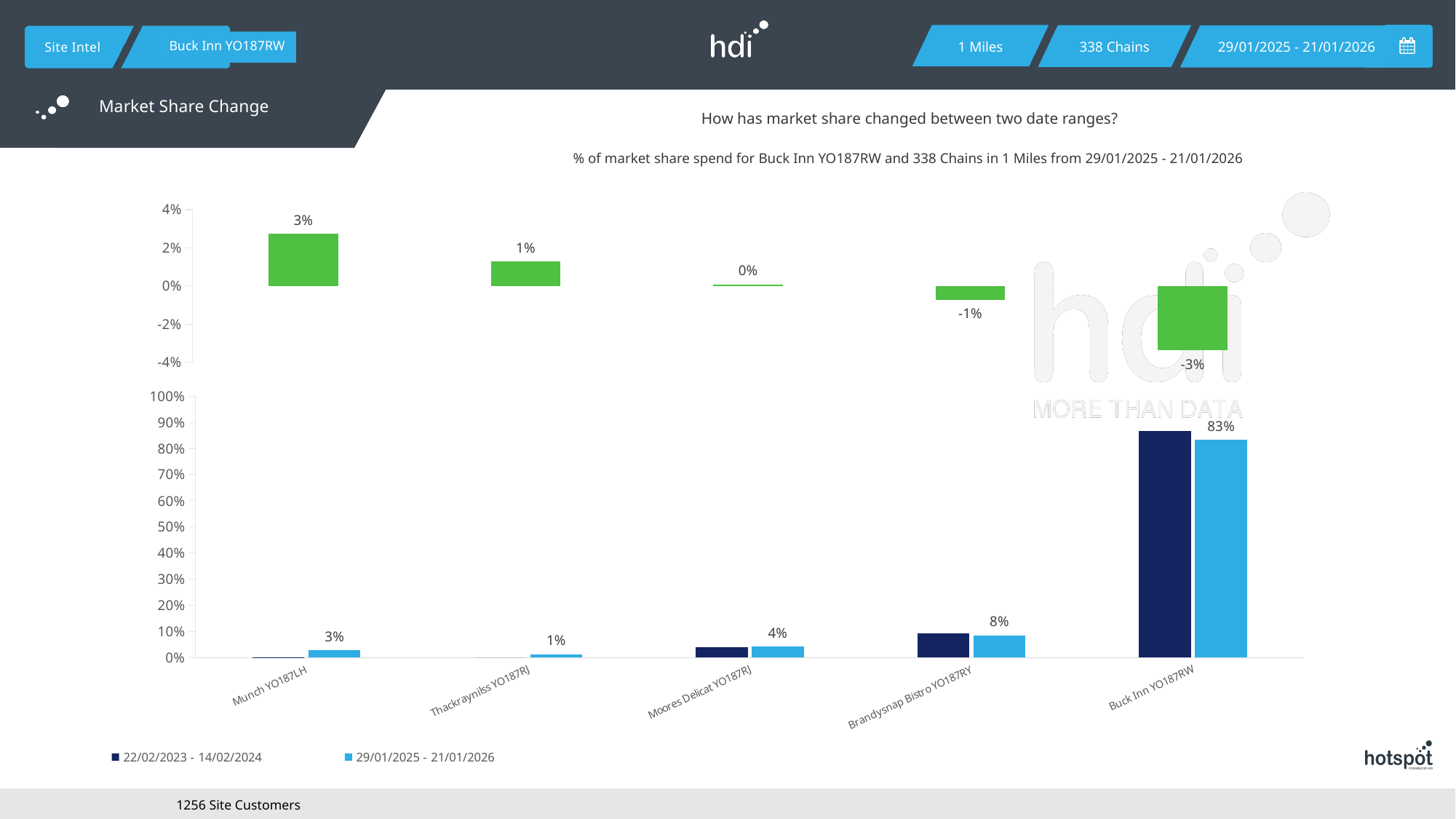
In the bottom chart, what is the value for Buck Inn YO187RW in the 29/01/2025 - 21/01/2026 series? 83% In the top chart (market share change), which category has the highest value? Munch YO187LH In the top chart (market share change), which category has the lowest value? Buck Inn YO187RW In the bottom chart, which is larger for the 29/01/2025 - 21/01/2026 series: Moores Delicat YO187RJ or Brandysnap Bistro YO187RY? Brandysnap Bistro YO187RY In the bottom chart, is the value for Buck Inn YO187RW in the 22/02/2023 - 14/02/2024 series greater or less than 80%? greater In the top chart (market share change), what is the value for Munch YO187LH? 3% In the bottom chart, what is the value for Brandysnap Bistro YO187RY in the 29/01/2025 - 21/01/2026 series? 8% In the top chart (market share change), what is the difference between the values for Munch YO187LH and Thackraynilss YO187RJ? 2% In the top chart (market share change), what is the value for Brandysnap Bistro YO187RY? -1% How many categories are shown on the x axis of the bottom chart? 5 In the top chart (market share change), what is the value for Buck Inn YO187RW? -3% How many series does the legend of the bottom chart list? 2